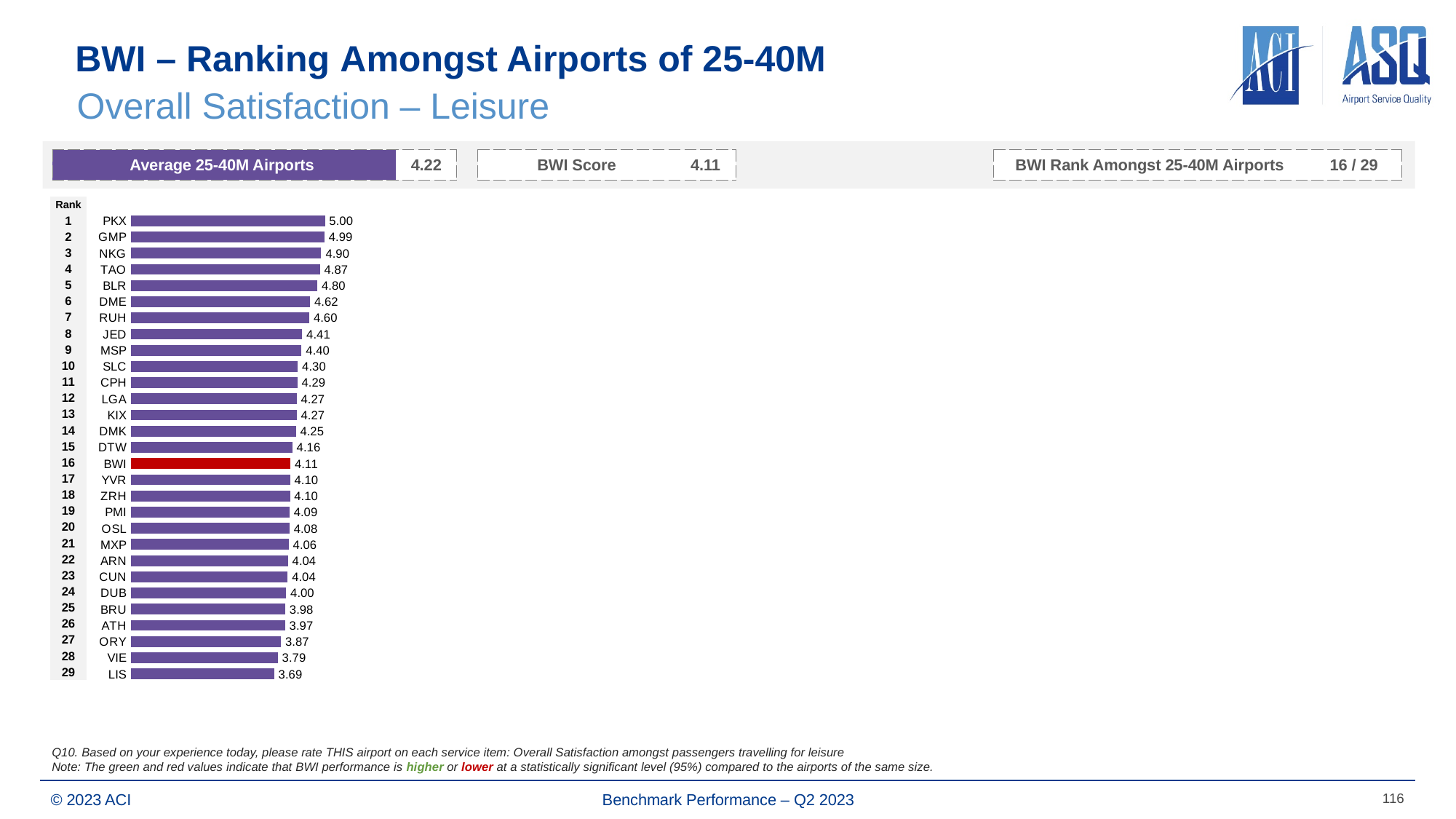
Which has a larger value, DME or MSP? DME Which airport has the highest value? PKX What is the value for PKX? 5.00 How many airports are ranked in the chart? 29 What kind of chart is shown? Bar chart What is BWI's rank amongst 25-40M airports? 16 / 29 What is the value for DTW? 4.16 What is the difference between the values for PKX and LIS? 1.31 What is the value for BWI? 4.11 Which airport has the lowest value? LIS What is the difference between the values for DTW and BWI? 0.05 Which bar is coloured red? BWI